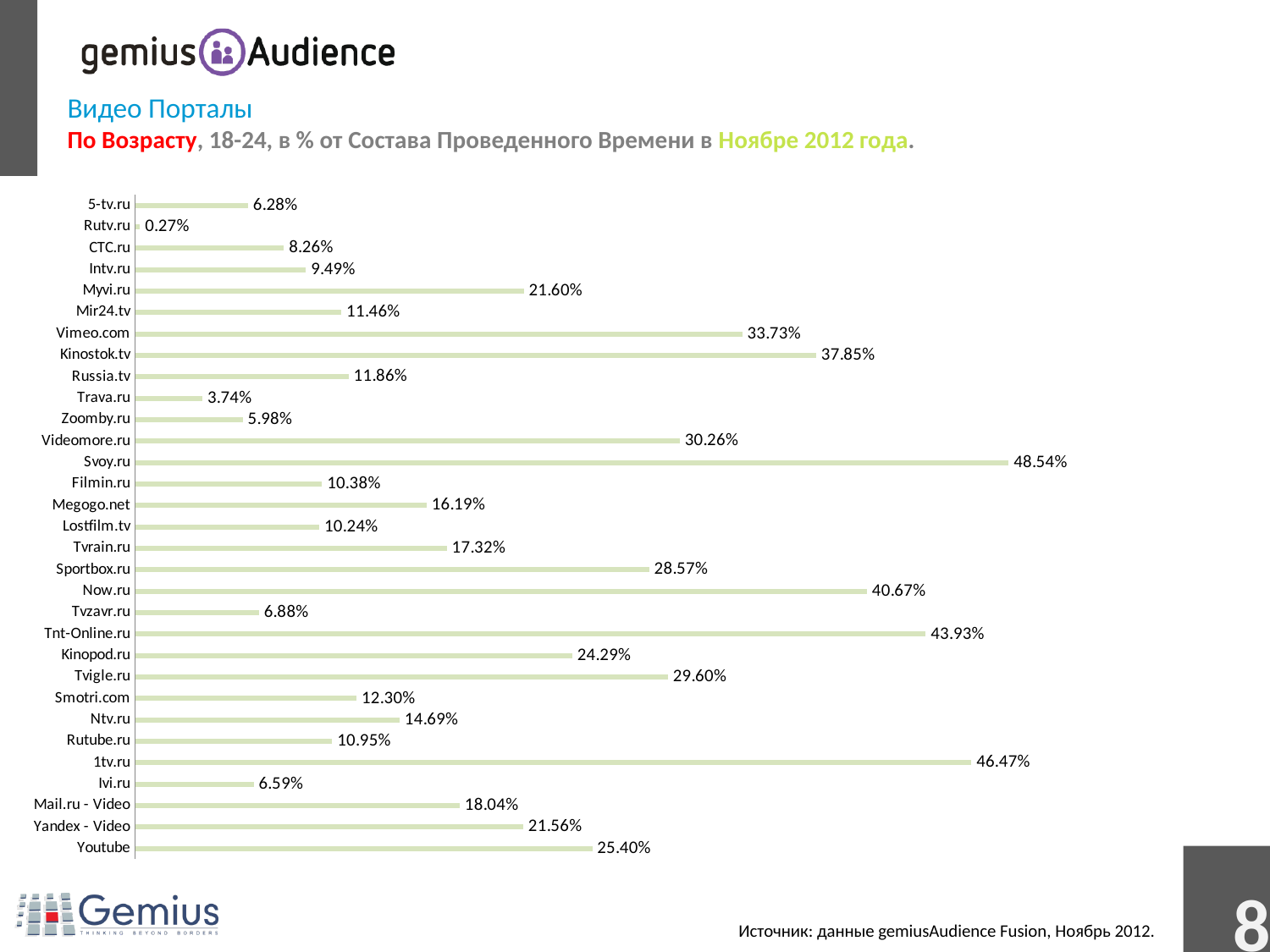
What is the value for Youtube? 25.40% What is the value for Kinostok.tv? 37.85% Which category has the lowest value? Rutv.ru How many categories are shown in the chart? 31 Which is larger, the value for Vimeo.com or the value for Videomore.ru? Vimeo.com What is the value for Svoy.ru? 48.54% What kind of chart is shown on the slide? Bar chart Which is larger, the value for Myvi.ru or the value for Kinopod.ru? Kinopod.ru What is the difference between the values for Now.ru and Sportbox.ru? 12.10% What is the difference between the values for 1tv.ru and Tnt-Online.ru? 2.54% What is the value for Mail.ru - Video? 18.04% Which category has the highest value? Svoy.ru